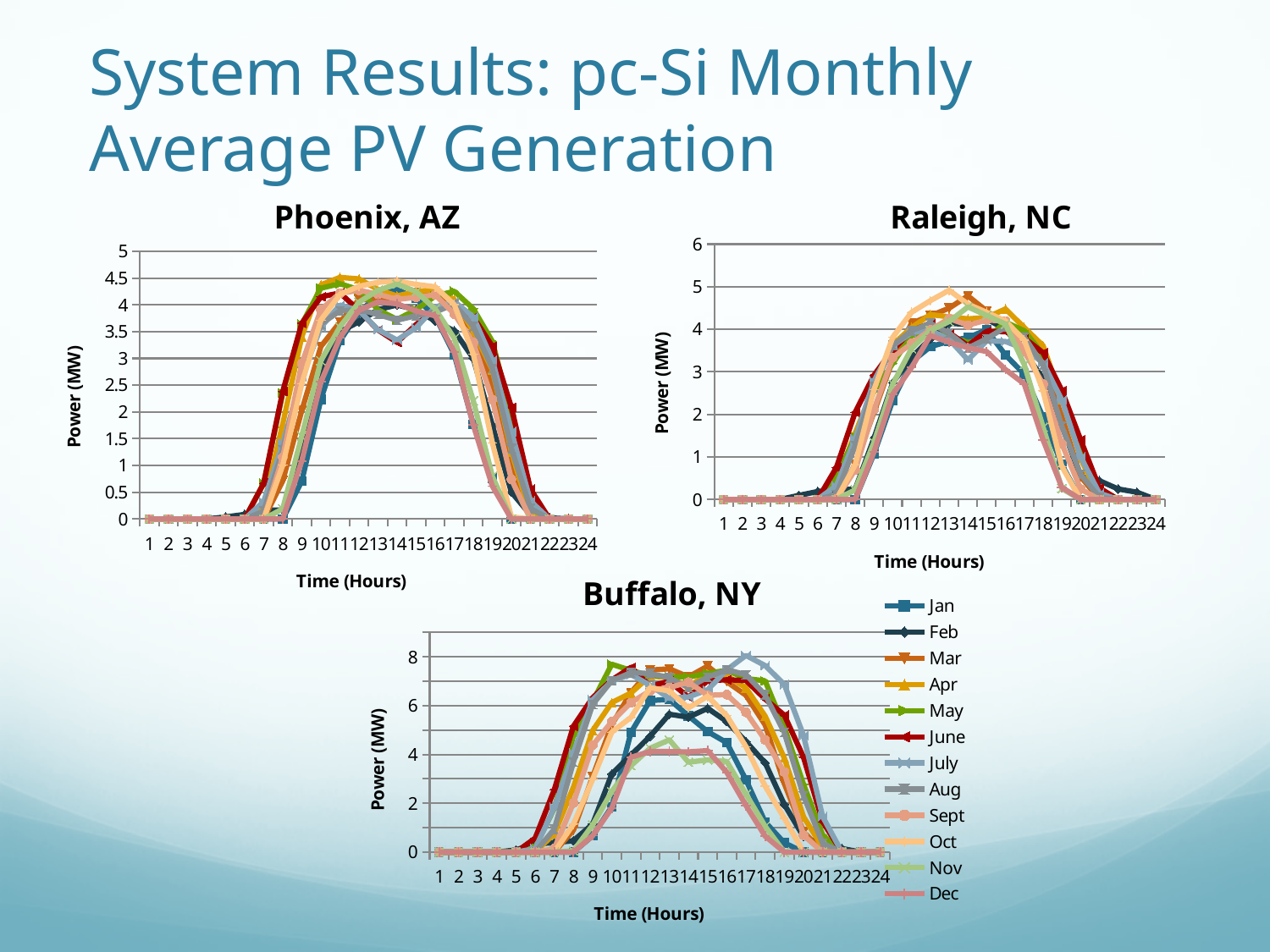
In the Phoenix, AZ chart, is the value for June at hour 12 greater or less than 3? greater In the Raleigh, NC chart, is the value for Dec at hour 24 greater or less than 1? less How many series does the legend list for the Buffalo, NY chart? 12 What is the x-axis label on the Phoenix, AZ chart? Time (Hours) In the Raleigh, NC chart, do the values for Apr rise or fall from hour 6 to hour 12? rise In the Buffalo, NY chart, is the value for July at hour 17 greater or less than 6? greater In the Phoenix, AZ chart, do the values for Jan rise or fall from hour 16 to hour 20? fall What is the y-axis label on the Buffalo, NY chart? Power (MW) What kind of chart is the Phoenix, AZ chart? line chart How many time points are plotted along the x axis of the Raleigh, NC chart? 24